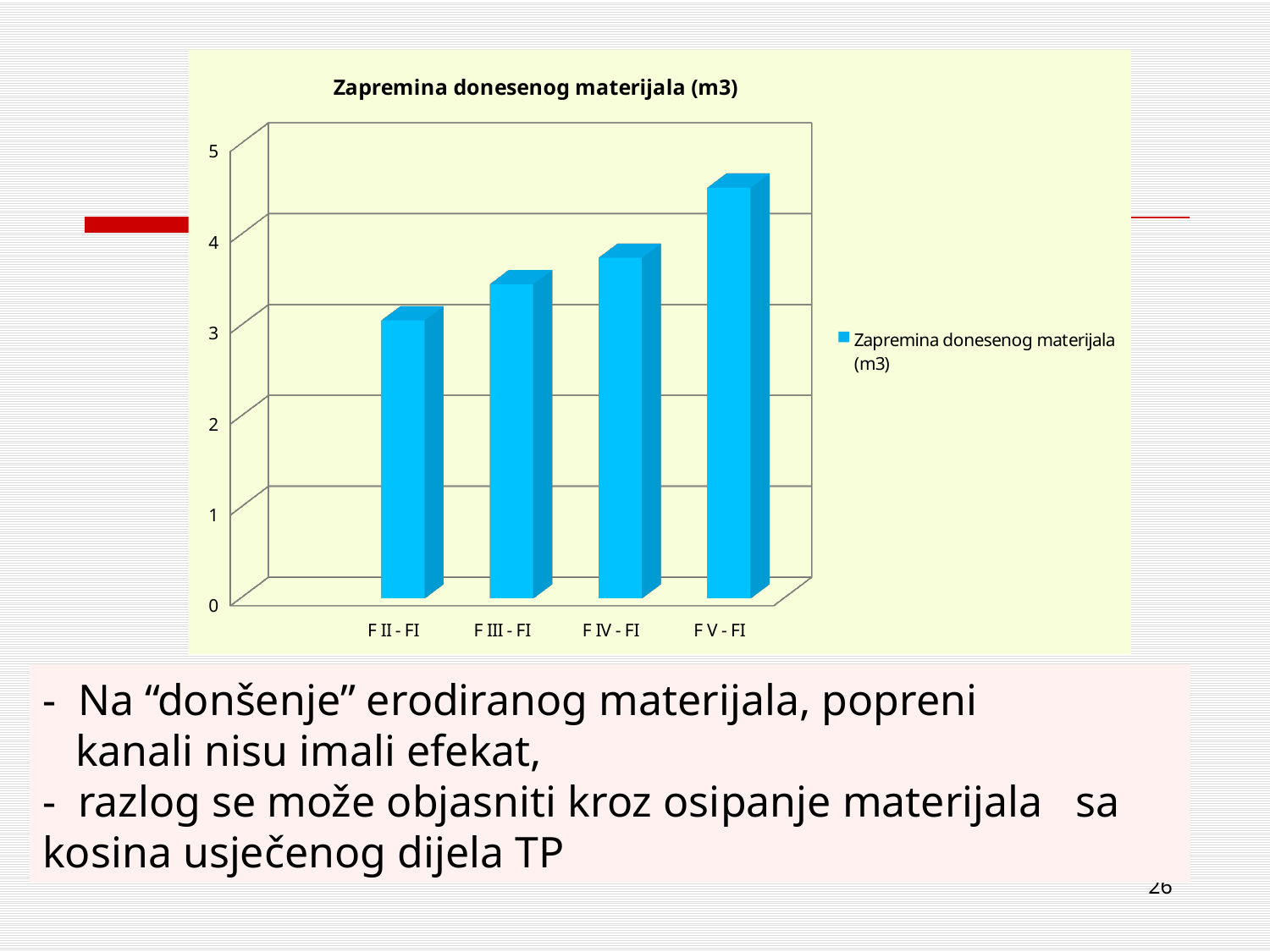
Do the values rise or fall from F II - FI to F V - FI along the x axis? rise How many series does the legend list? 1 What kind of chart is shown on the slide? bar chart Is the value for F III - FI greater or less than 3? greater Is the value for F V - FI greater or less than 4? greater How many categories are shown on the x axis of the chart? 4 Which category has the highest value? F V - FI Which category has the lowest value? F II - FI What is the title of the chart? Zapremina donesenog materijala (m3) Is the value for F IV - FI greater or less than 4? less Which is larger, the value for F V - FI or the value for F III - FI? F V - FI